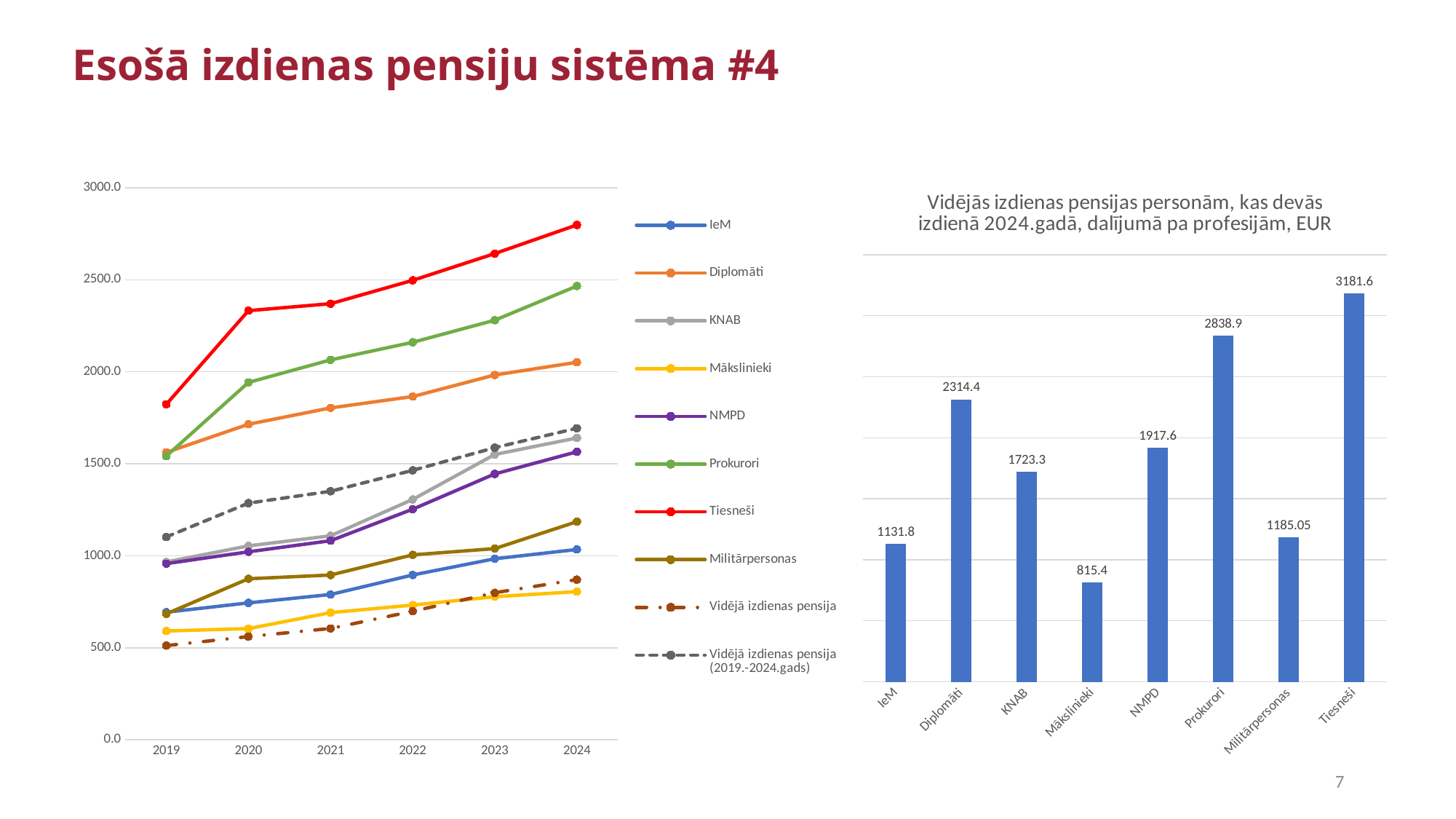
In the bar chart on the right, which profession has the lowest average pension? Mākslinieki How many series does the legend of the line chart on the left list? 10 In the bar chart on the right, which is larger: the value for Diplomāti or the value for KNAB? Diplomāti In the line chart on the left, does the Tiesneši series rise or fall from 2019 to 2024? rise In the line chart on the left, is the value for Tiesneši in 2024 greater or less than 2500.0? greater In the bar chart on the right, what is the difference between the values for Tiesneši and Mākslinieki? 2366.2 What is the title of the chart on the right? Vidējās izdienas pensijas personām, kas devās izdienā 2024.gadā, dalījumā pa profesijām, EUR How many professions are shown in the bar chart on the right? 8 In the bar chart on the right, what is the value for Mākslinieki? 815.4 In the bar chart on the right, which profession has the highest average pension? Tiesneši In the bar chart on the right, what is the value for Prokurori? 2838.9 What kind of chart is the chart on the left? line chart